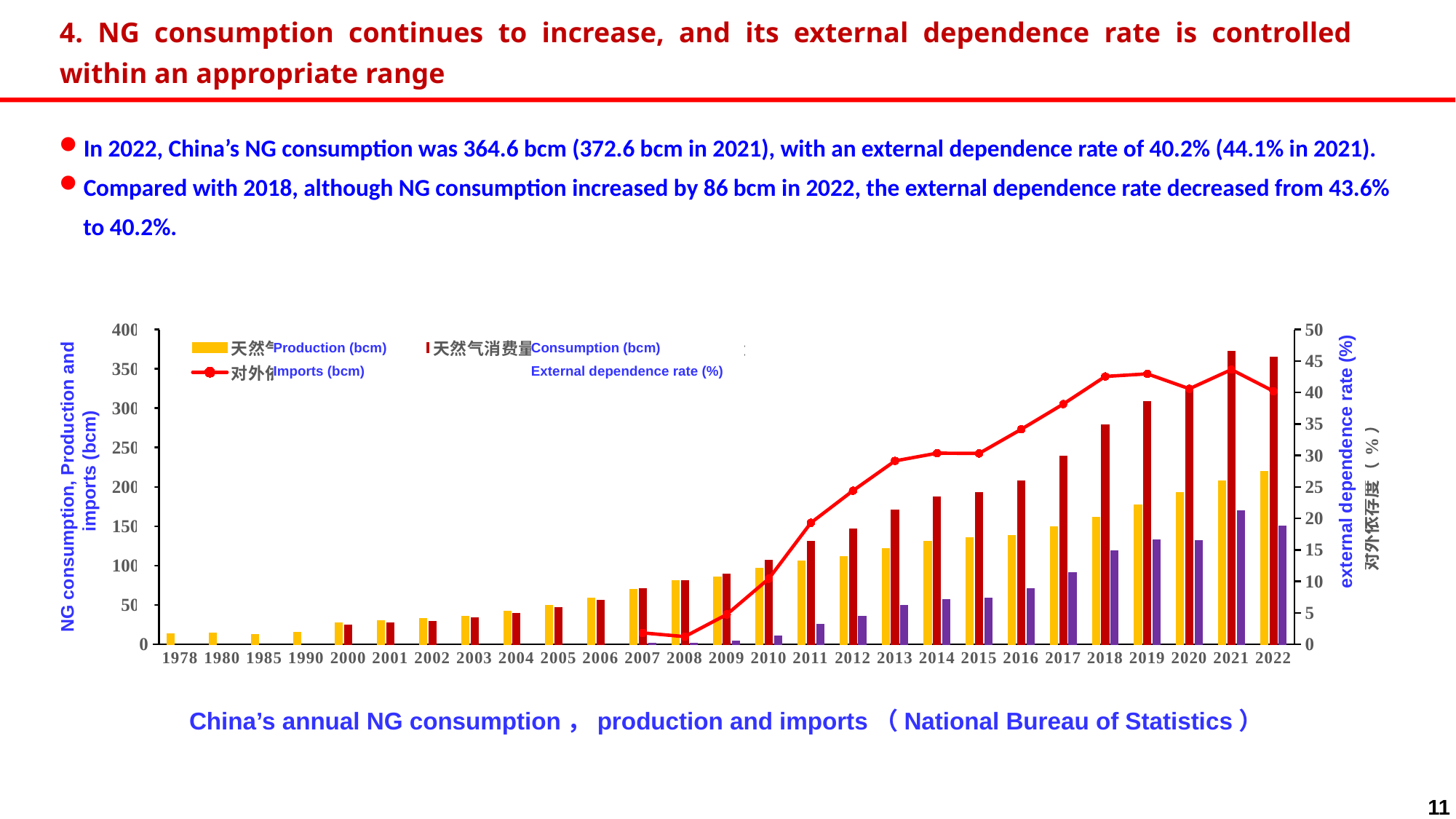
Is the Imports value for 2021 greater or less than 150? greater According to the slide, what was China's NG consumption in 2022? 364.6 bcm By how much did NG consumption in 2021 exceed that in 2022, based on the values given on the slide? 8 bcm In which year is the Production bar the tallest? 2022 Is the external dependence rate for 2010 greater or less than 15%? less Is the Consumption value for 2022 greater or less than 350? greater What kind of chart is shown on the slide? A combined bar and line chart In which year is the Consumption bar the tallest? 2021 Does the Consumption series generally rise or fall from 1978 to 2022? rise How many series does the chart legend list? 4 According to the slide, what was the external dependence rate in 2021? 44.1% How many years are shown on the x axis of the chart? 27